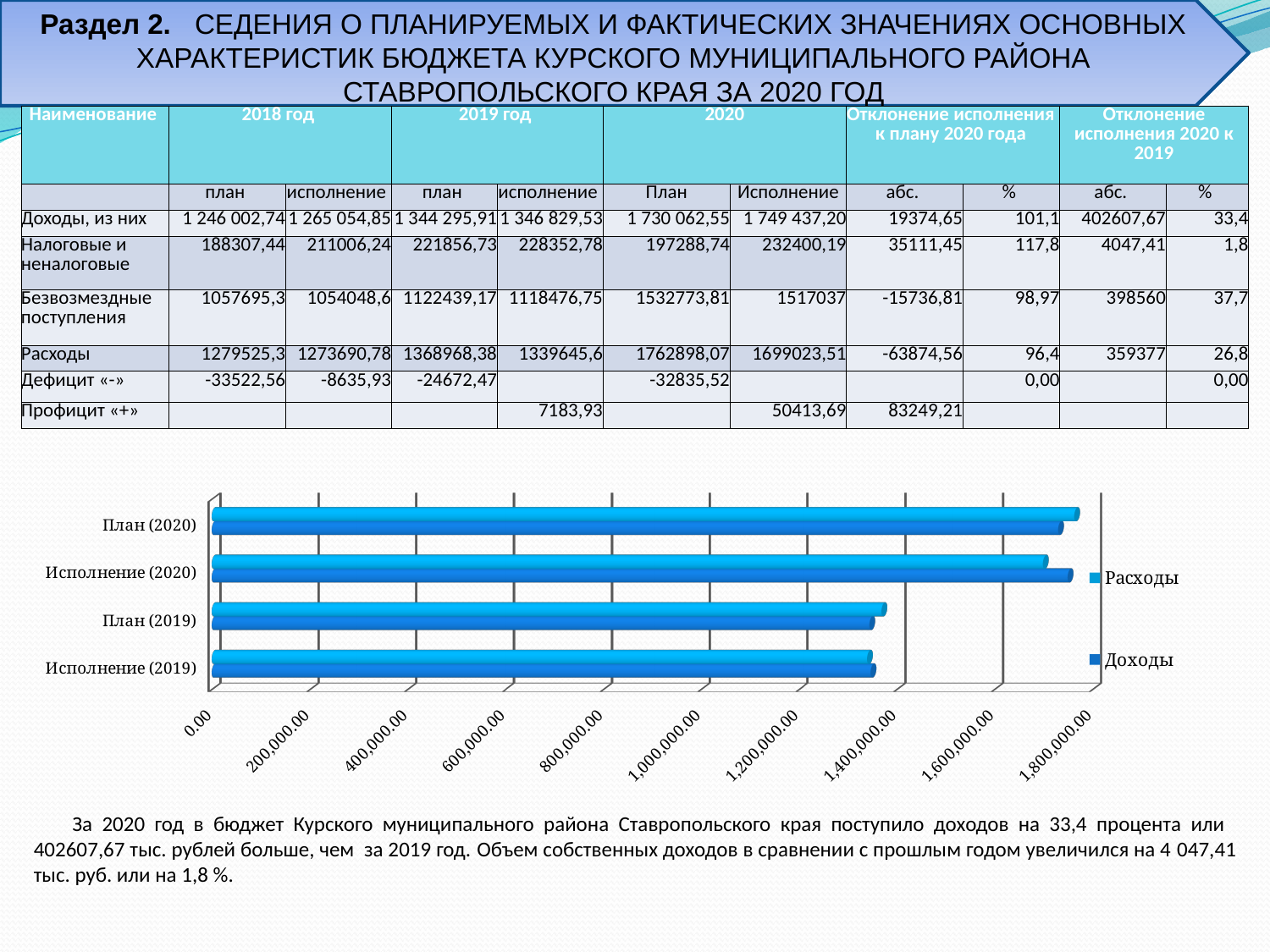
Is the Расходы value for План (2019) greater or less than 1,200,000.00? greater Is the Доходы value for Исполнение (2019) greater or less than 1,400,000.00? less How many series does the chart legend list? 2 How many categories are shown on the vertical axis of the chart? 4 Which category has the longest Расходы bar? План (2020) Is the Расходы value for План (2020) greater or less than 1,600,000.00? greater For Исполнение (2020), which is larger: Расходы or Доходы? Доходы Which series are listed in the chart legend? Расходы, Доходы What kind of chart is shown on the slide? bar chart Which category has the longest Доходы bar? Исполнение (2020) What is the highest value shown on the chart's horizontal axis? 1,800,000.00